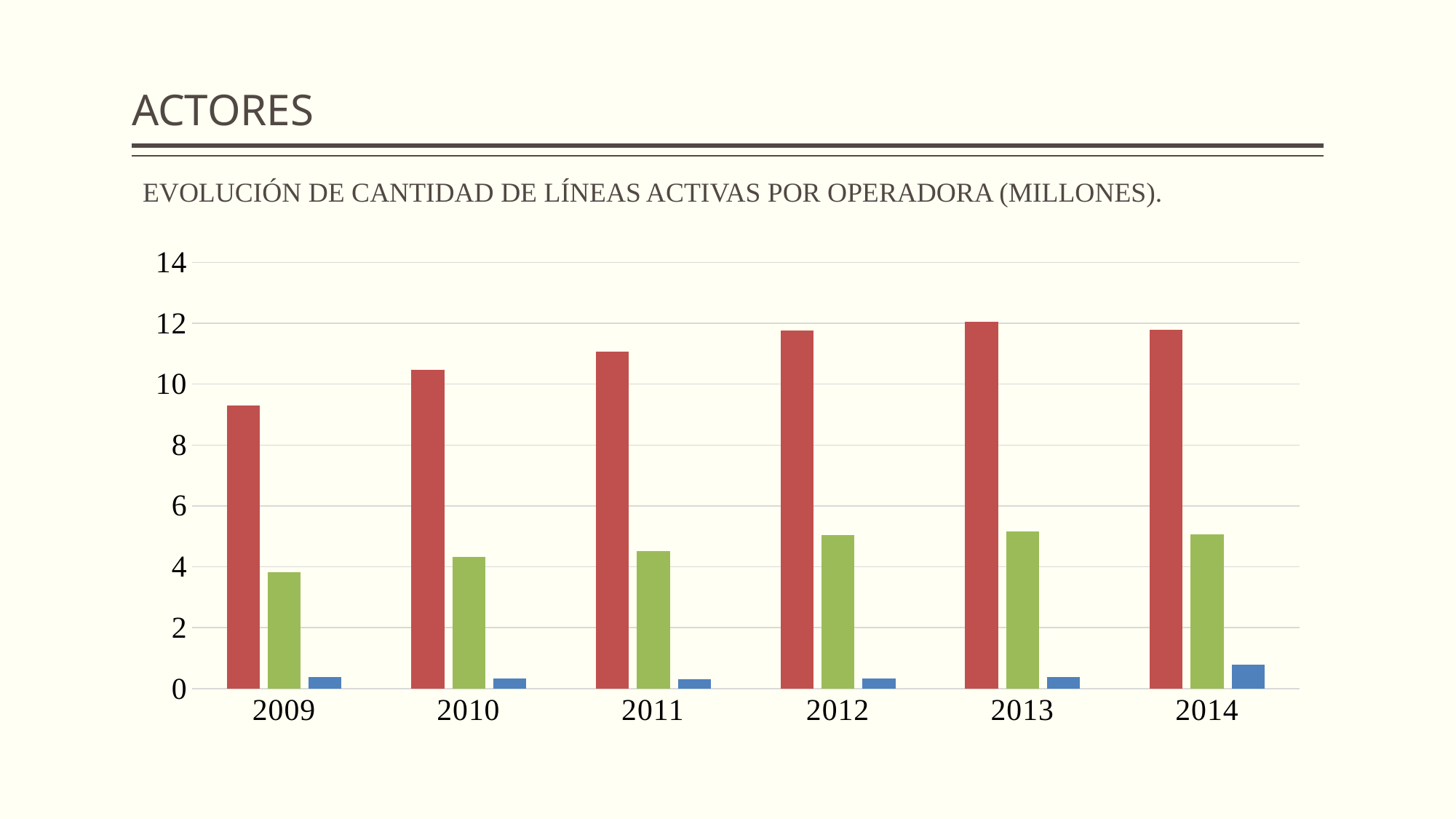
Do the red bars rise or fall from 2009 to 2013? rise What kind of chart is shown on the slide? bar chart In 2010, which is larger, the red bar or the green bar? the red bar Is the value of the red bar for 2011 greater or less than 10? greater How many bars are plotted for each year in the chart? 3 Is the value of the red bar for 2009 greater or less than 8? greater Is the value of the blue bar for 2014 greater or less than 2? less In which year is the blue bar the highest? 2014 What is the title text above the chart? EVOLUCIÓN DE CANTIDAD DE LÍNEAS ACTIVAS POR OPERADORA (MILLONES). How many years are shown along the x axis of the chart? 6